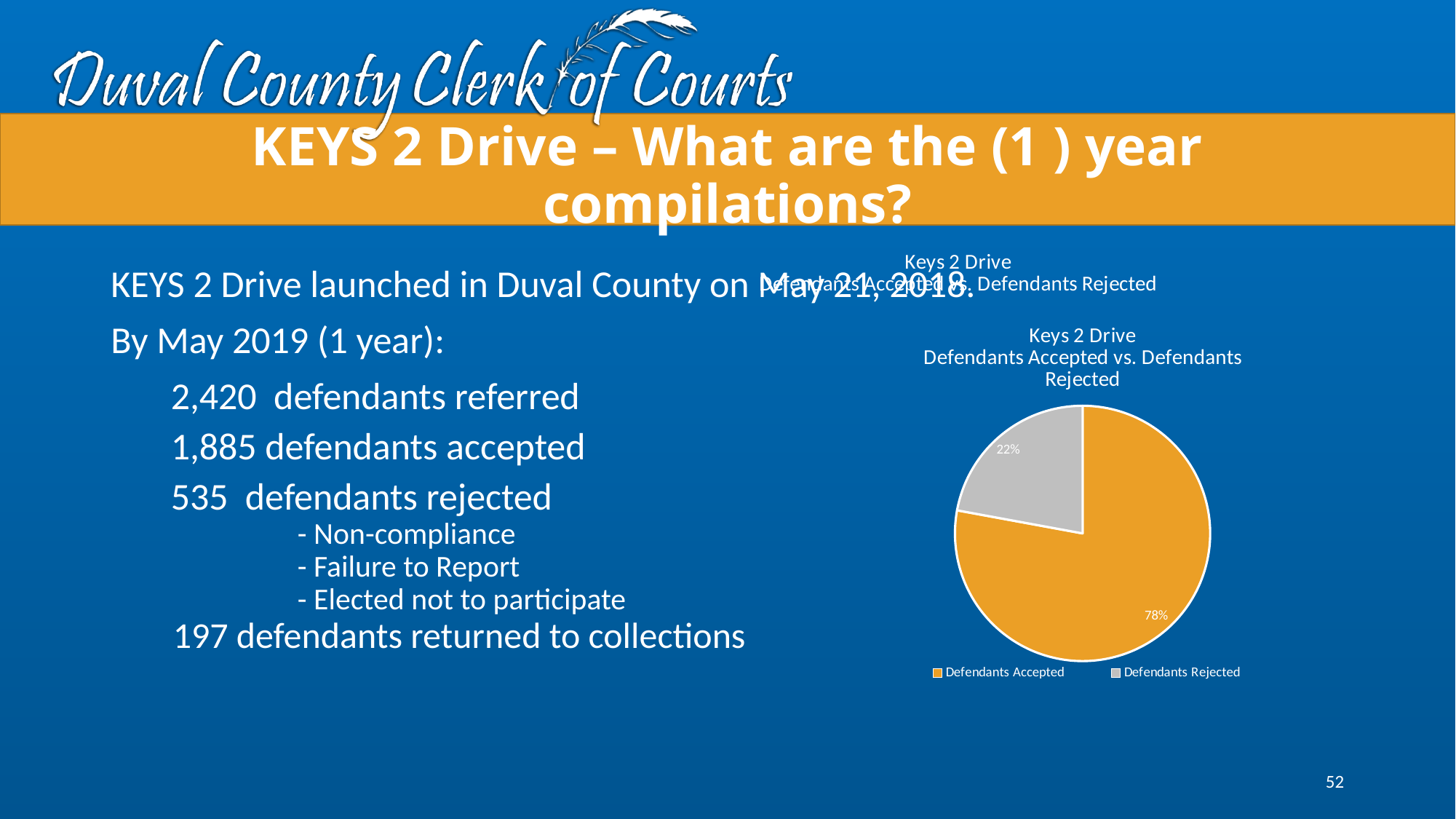
What share of the pie does Defendants Rejected represent? 22% Which slice of the pie is the largest? Defendants Accepted How many entries does the legend list? 2 What kind of chart is shown on the slide? pie chart What colour is the Defendants Rejected slice? grey What is the difference in percentage points between the Defendants Accepted share and the Defendants Rejected share? 56 Which slice of the pie is the smallest? Defendants Rejected What share of the pie does Defendants Accepted represent? 78% How many slices does the pie chart have? 2 Which is larger, the share for Defendants Accepted or the share for Defendants Rejected? Defendants Accepted What is the title of the pie chart? Keys 2 Drive Defendants Accepted vs. Defendants Rejected